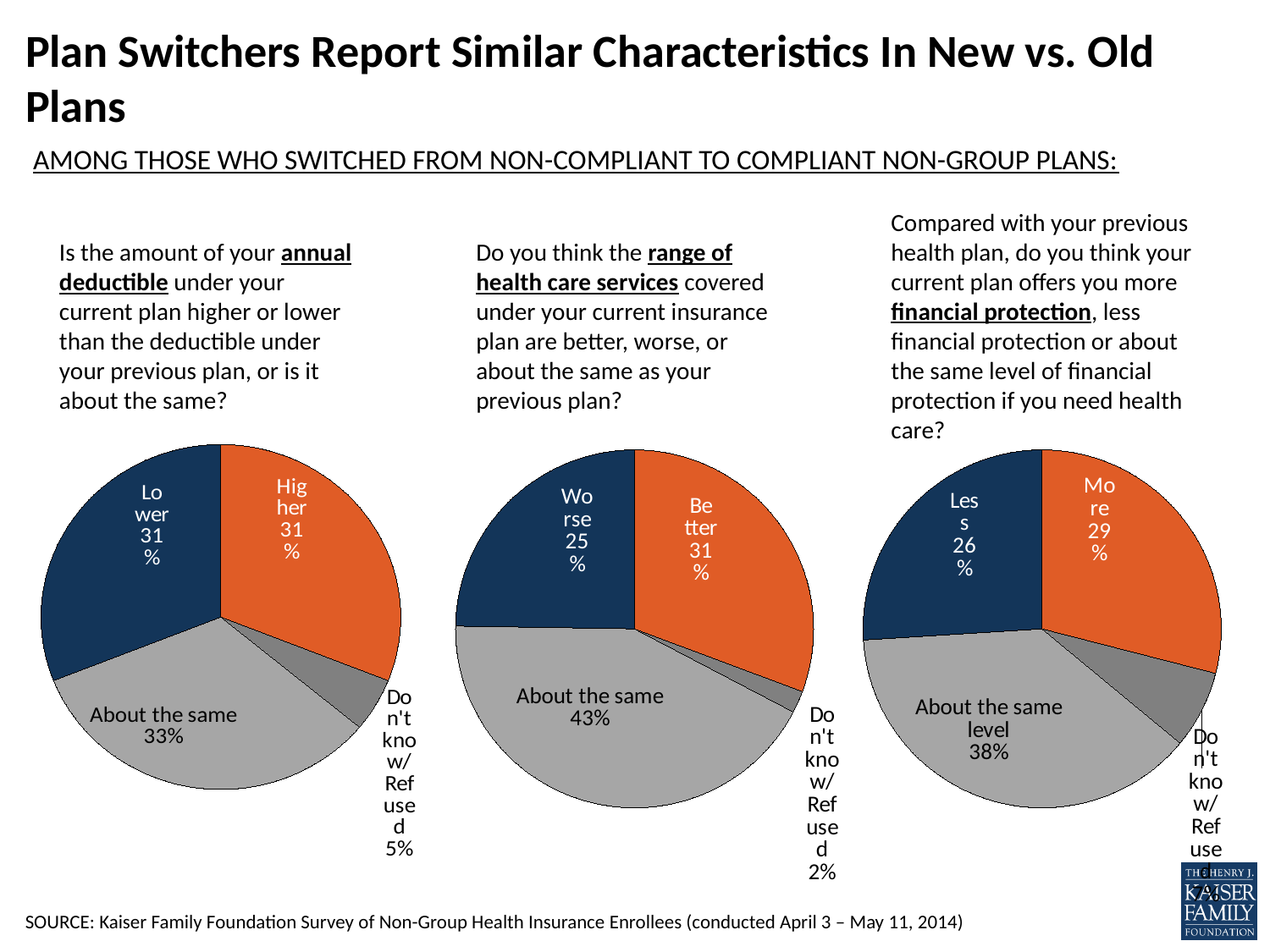
How many pie charts are shown on the slide? 3 In the right pie chart about financial protection, which is larger: the 'More' share or the 'Less' share? More In the left pie chart about the annual deductible, what share said 'About the same'? 33% In the middle pie chart about the range of health care services, which response has the largest share? About the same In the right pie chart about financial protection, what share said 'About the same level'? 38% In the left pie chart about the annual deductible, what share of respondents said their deductible is higher? 31% In the right pie chart about financial protection, what share said 'More'? 29% In the middle pie chart about the range of health care services, what is the difference between the 'Better' and 'Worse' shares? 6 percentage points In the middle pie chart about the range of health care services, what share said 'Don't know/Refused'? 2% In the middle pie chart about the range of health care services, what share said 'Worse'? 25% In the left pie chart about the annual deductible, which response has the smallest share? Don't know/Refused What type of chart is used on this slide? Pie chart